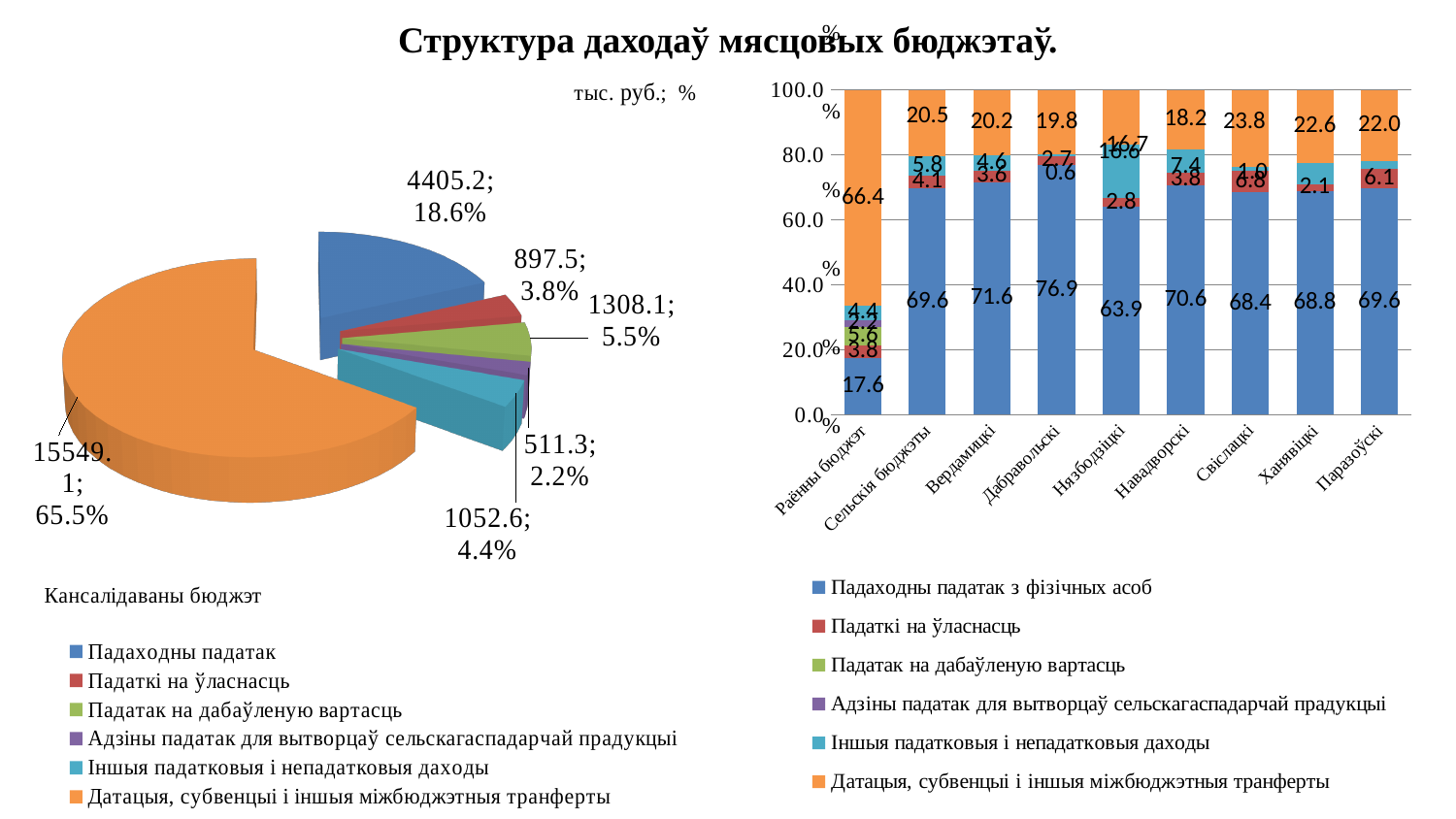
How many series does the legend of the pie chart on the left list? 6 In the pie chart on the left, what is the difference between the values for Падатак на дабаўленую вартасць (1308.1) and Падаткі на ўласнасць (897.5)? 410.6 In the bar chart on the right, what is the value of Падаходны падатак з фізічных асоб for Дабравольскі? 76.9 In the pie chart on the left, what share does the Датацыі, субвенцыі і іншыя міжбюджэтныя трансферты slice have? 65.5% How many categories are shown on the x axis of the bar chart on the right? 9 In the bar chart on the right, which is larger: the Датацыі value for Свіслацкі or for Навадворскі? Свіслацкі In the bar chart on the right, is the Падаходны падатак з фізічных асоб value for Раённы бюджэт greater or less than 20.0? less In the bar chart on the right, what is the value of Датацыі, субвенцыі і іншыя міжбюджэтныя трансферты for Раённы бюджэт? 66.4 In the bar chart on the right, which category has the highest value for Падаходны падатак з фізічных асоб? Дабравольскі What kind of chart is the chart on the right? Stacked bar chart In the pie chart on the left, which category has the smallest slice? Адзіны падатак для вытворцаў сельскагаспадарчай прадукцыі In the pie chart on the left, what value and share are shown for Падаходны падатак (the blue slice)? 4405.2; 18.6%